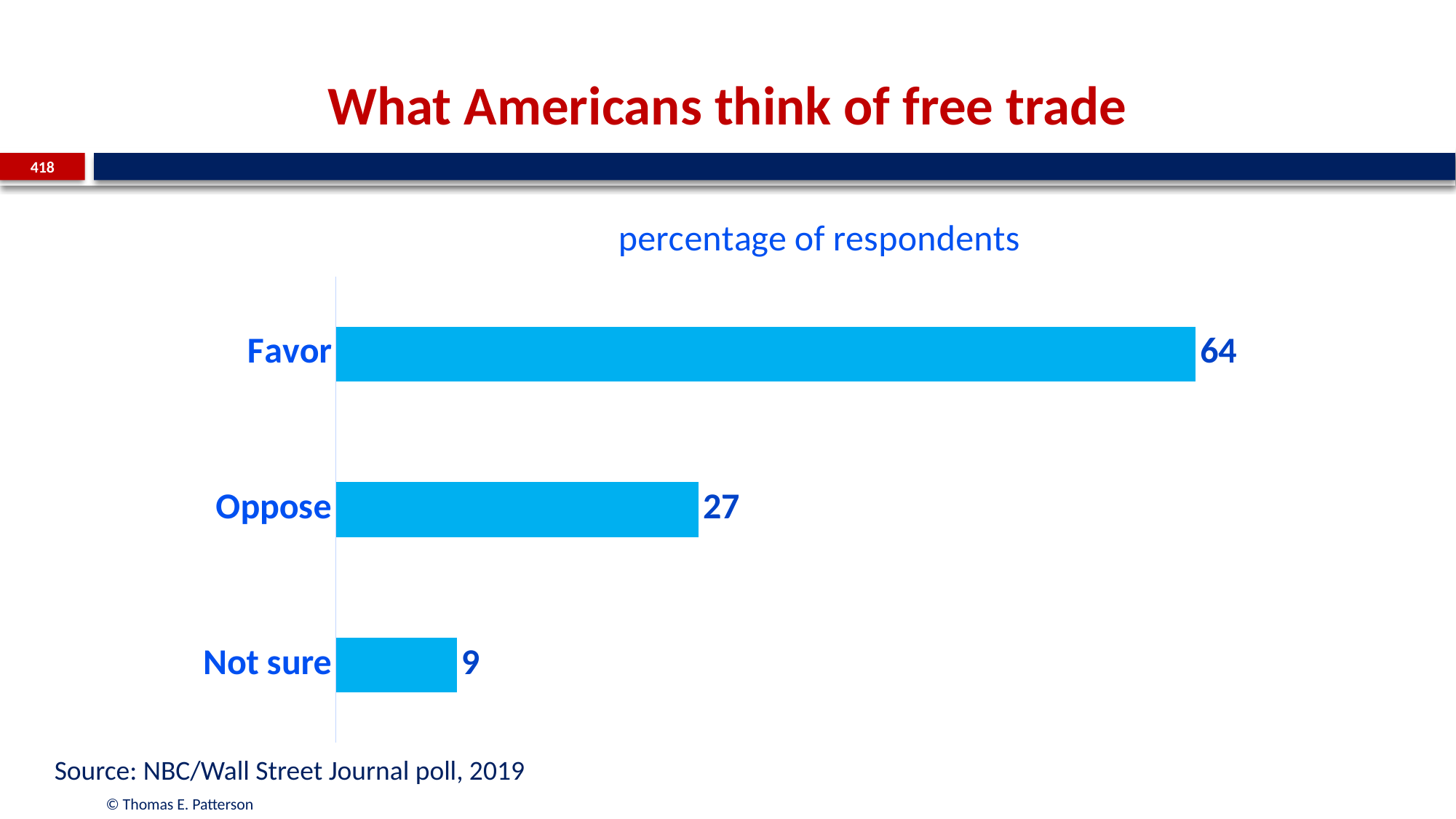
How many categories are shown in the chart? 3 What is the difference between the percentage who favor and the percentage who oppose free trade? 37 What kind of chart is shown on the slide? Bar chart What is the difference between the percentage who oppose free trade and the percentage who are not sure? 18 What percentage of respondents oppose free trade? 27 Which category has the lowest percentage of respondents? Not sure What is the source of the data shown in the chart? NBC/Wall Street Journal poll, 2019 Which is larger, the percentage who oppose free trade or the percentage who are not sure? Oppose What percentage of respondents are not sure about free trade? 9 What is the title of the chart? percentage of respondents Which category has the highest percentage of respondents? Favor What percentage of respondents favor free trade? 64